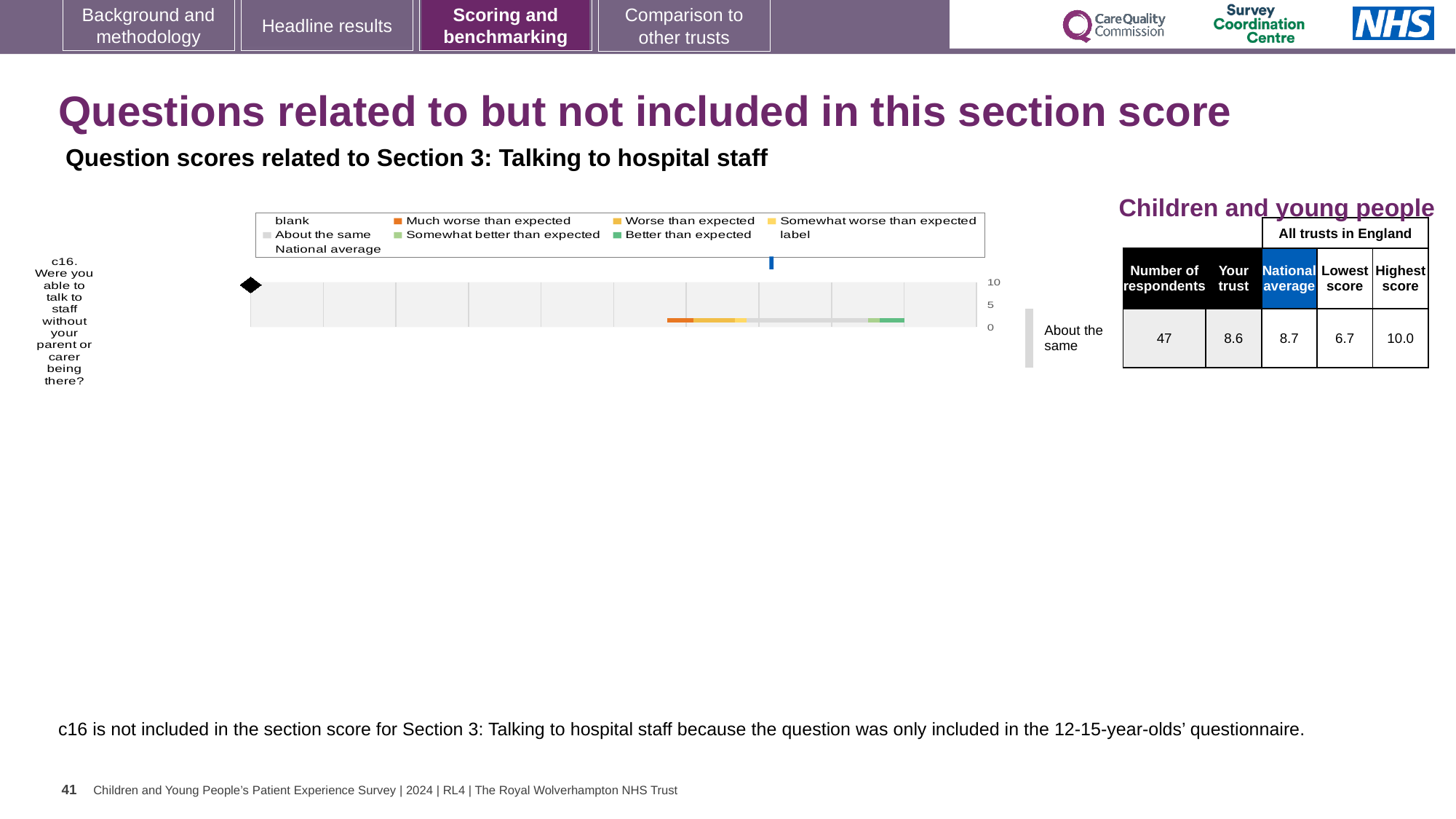
In the table beside the chart, what is the 'Your trust' score for c16? 8.6 Which question is plotted in the chart? c16. Were you able to talk to staff without your parent or carer being there? How many entries does the chart legend list? 9 In the table beside the chart, what is the national average score for c16? 8.7 What is the highest tick value shown on the chart's axis? 10 In the table beside the chart, what is the difference between the highest score and the lowest score for c16? 3.3 What kind of chart is shown on the slide? bar chart How many survey questions are plotted in the chart? 1 In the table beside the chart, which is larger for c16: the 'Your trust' score or the national average? National average What category label is shown next to the chart for c16? About the same What colour does the legend use for 'Much worse than expected'? orange In the table beside the chart, how many respondents answered c16? 47